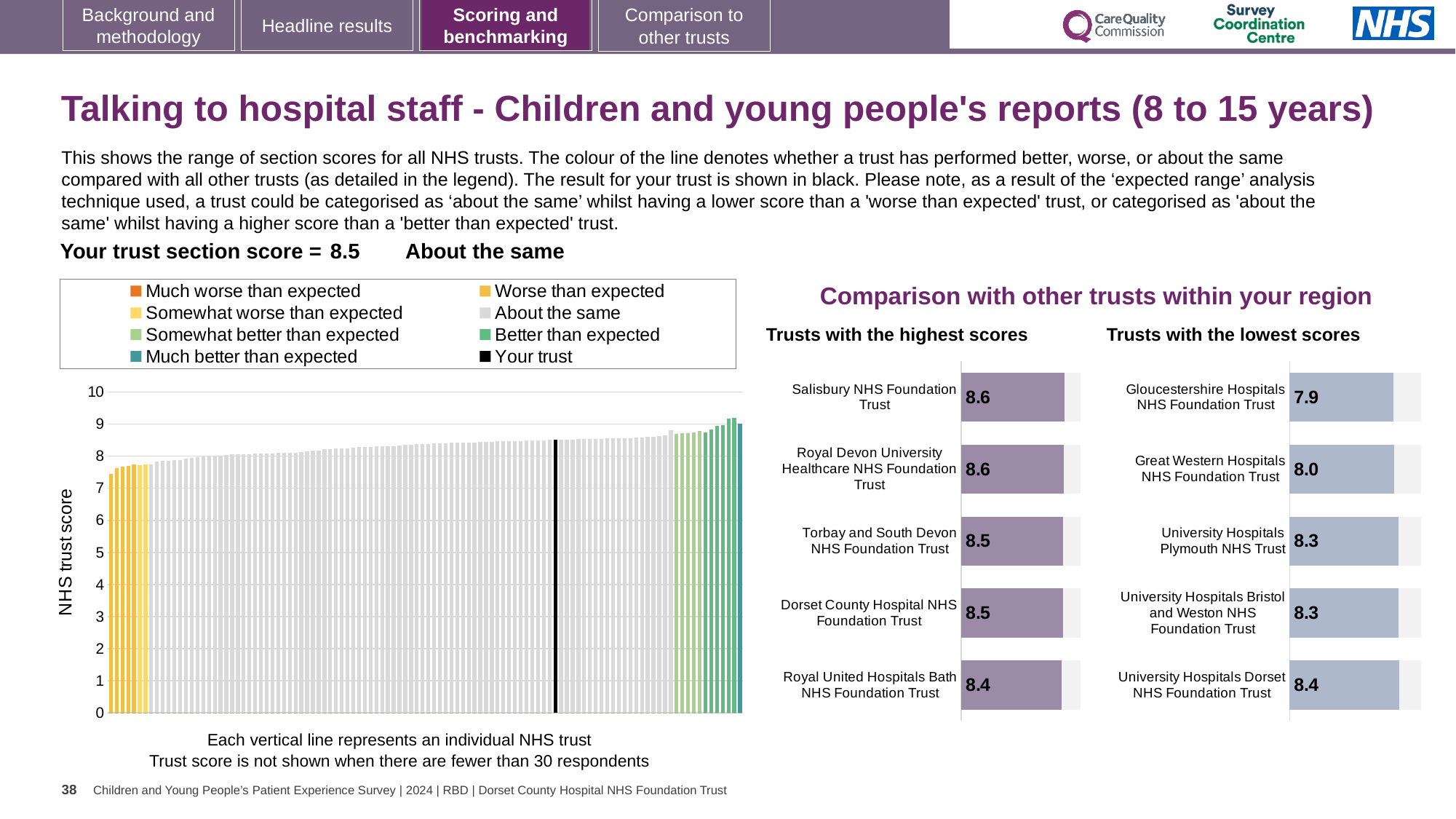
In the 'Trusts with the highest scores' chart, what is the score for Salisbury NHS Foundation Trust? 8.6 In the 'Trusts with the lowest scores' chart, which trust has the highest score? University Hospitals Dorset NHS Foundation Trust What kind of chart is the 'NHS trust score' chart on the left of the slide? Bar chart In the 'NHS trust score' chart on the left, is the value for the black 'Your trust' bar greater or less than 8? greater In the 'Trusts with the lowest scores' chart, what is the score for Gloucestershire Hospitals NHS Foundation Trust? 7.9 In the 'Trusts with the highest scores' chart, what is the score for Royal United Hospitals Bath NHS Foundation Trust? 8.4 In the 'Trusts with the lowest scores' chart, what is the difference between the scores of University Hospitals Dorset NHS Foundation Trust and Gloucestershire Hospitals NHS Foundation Trust? 0.5 In the 'Trusts with the lowest scores' chart, which has the higher score: Great Western Hospitals NHS Foundation Trust or University Hospitals Plymouth NHS Trust? University Hospitals Plymouth NHS Trust How many entries does the legend of the 'NHS trust score' chart on the left list? 8 How many trusts are shown in the 'Trusts with the highest scores' chart? 5 In the 'Trusts with the lowest scores' chart, which trust has the lowest score? Gloucestershire Hospitals NHS Foundation Trust In the 'Trusts with the highest scores' chart, which trust has the lowest score? Royal United Hospitals Bath NHS Foundation Trust